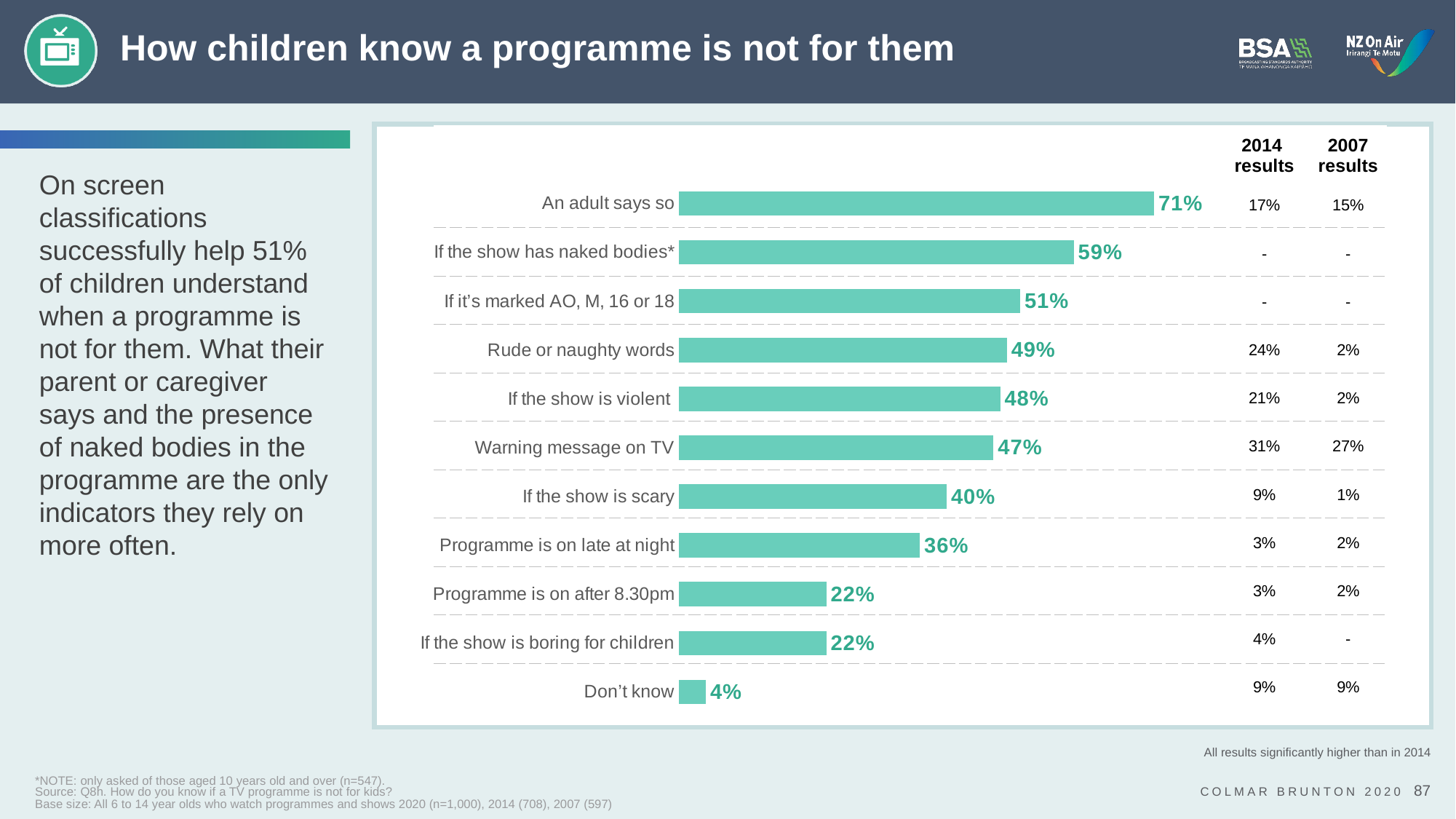
What percentage of children say they know a programme is not for them because an adult says so? 71% What is the value for 'If it's marked AO, M, 16 or 18'? 51% What was the 2014 result for 'Warning message on TV'? 31% What is the value for 'Programme is on late at night'? 36% What is the difference between the values for 'An adult says so' and 'If the show has naked bodies*'? 12% How many categories are shown in the bar chart? 11 Which category has the highest value in the chart? An adult says so What is the title of the slide containing the chart? How children know a programme is not for them What type of chart is shown on the slide? Bar chart What was the 2007 result for 'Rude or naughty words'? 2% Which is larger: the value for 'If the show is scary' or the value for 'Programme is on after 8.30pm'? If the show is scary Which category has the lowest value in the chart? Don't know